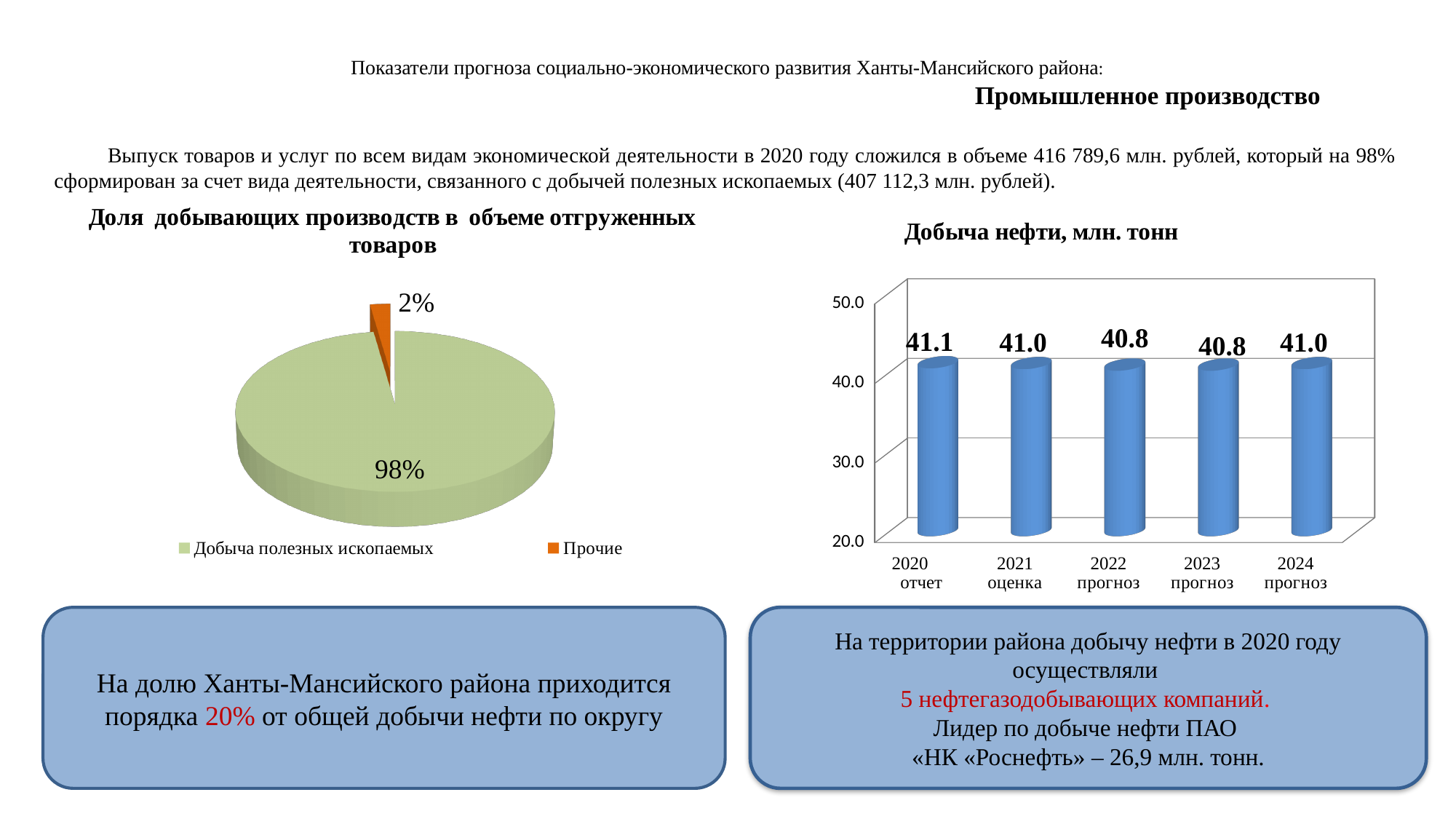
In the chart 'Добыча нефти, млн. тонн', what is the value for 2024 прогноз? 41.0 In the chart 'Добыча нефти, млн. тонн', what is the value for 2020 отчет? 41.1 In the chart 'Добыча нефти, млн. тонн', what is the difference between the values for 2020 отчет and 2023 прогноз? 0.3 In the pie chart 'Доля добывающих производств в объеме отгруженных товаров', what share does 'Добыча полезных ископаемых' have? 98% How many entries does the legend of the pie chart 'Доля добывающих производств в объеме отгруженных товаров' list? 2 In the chart 'Добыча нефти, млн. тонн', is the value for 2023 прогноз greater or less than 30.0? greater What kind of chart is 'Добыча нефти, млн. тонн'? bar chart In the pie chart 'Доля добывающих производств в объеме отгруженных товаров', what share does 'Прочие' have? 2% In the chart 'Добыча нефти, млн. тонн', which is larger: the value for 2021 оценка or the value for 2022 прогноз? 2021 оценка How many years are shown in the chart 'Добыча нефти, млн. тонн'? 5 In the chart 'Добыча нефти, млн. тонн', what is the value for 2022 прогноз? 40.8 In the chart 'Добыча нефти, млн. тонн', which year has the highest value? 2020 отчет